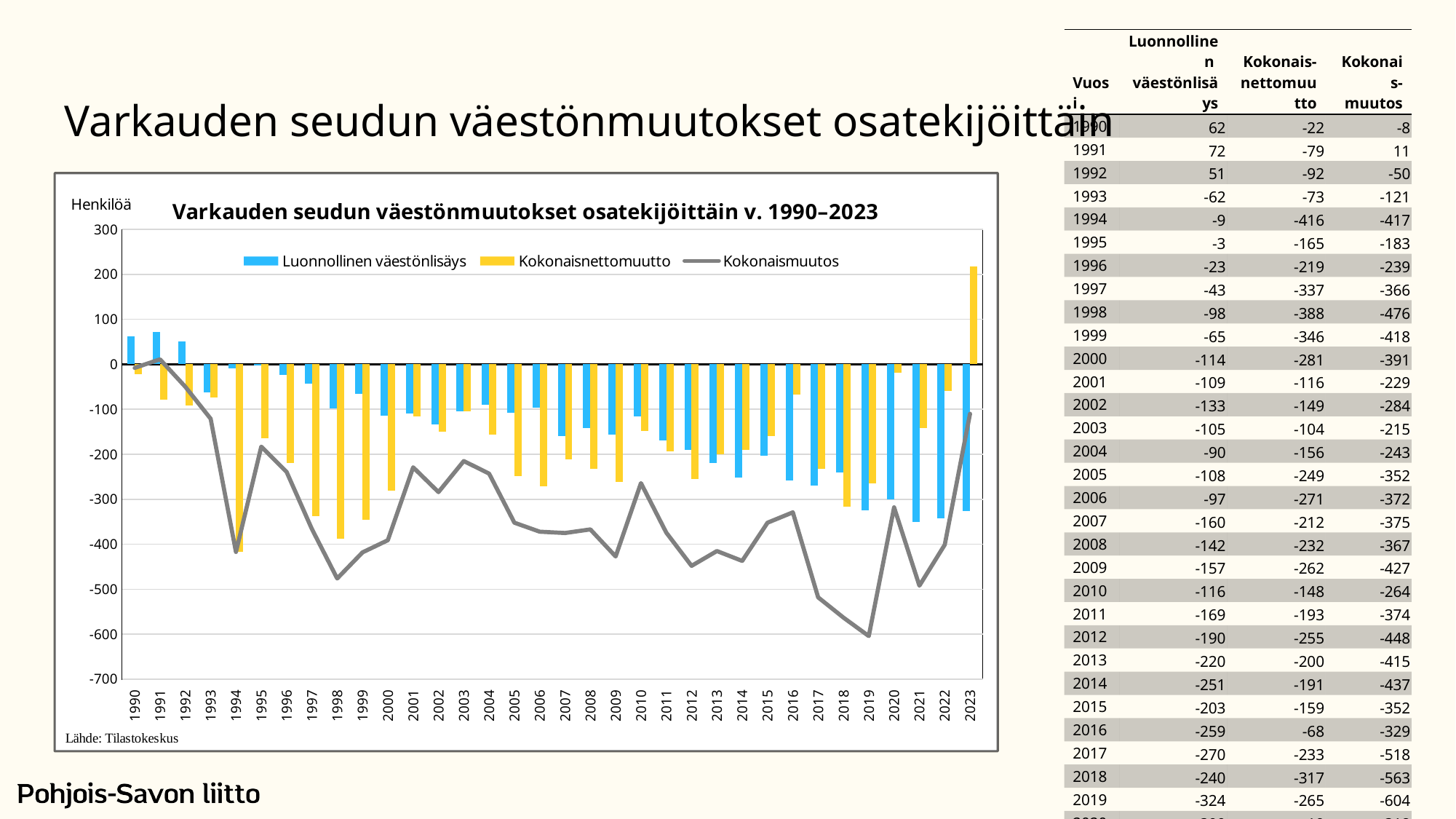
How many years are plotted along the x axis of the chart? 34 What is the Luonnollinen väestönlisäys value for 2019? -324 What colour are the Kokonaisnettomuutto bars in the chart? Yellow What is the Kokonaisnettomuutto value for 1998? -388 What is the difference between the Kokonaismuutos values for 2017 and 2018? 45 Which year has the larger Luonnollinen väestönlisäys value, 1990 or 1991? 1991 What is the Kokonaismuutos value for 1994? -417 In which year is the Kokonaisnettomuutto bar highest? 2023 Is the Kokonaisnettomuutto value for 2023 greater or less than 200? greater How many series does the chart legend list? 3 In which year is the Kokonaismuutos line at its lowest? 2019 What kind of chart is shown on the slide? Combined bar and line chart